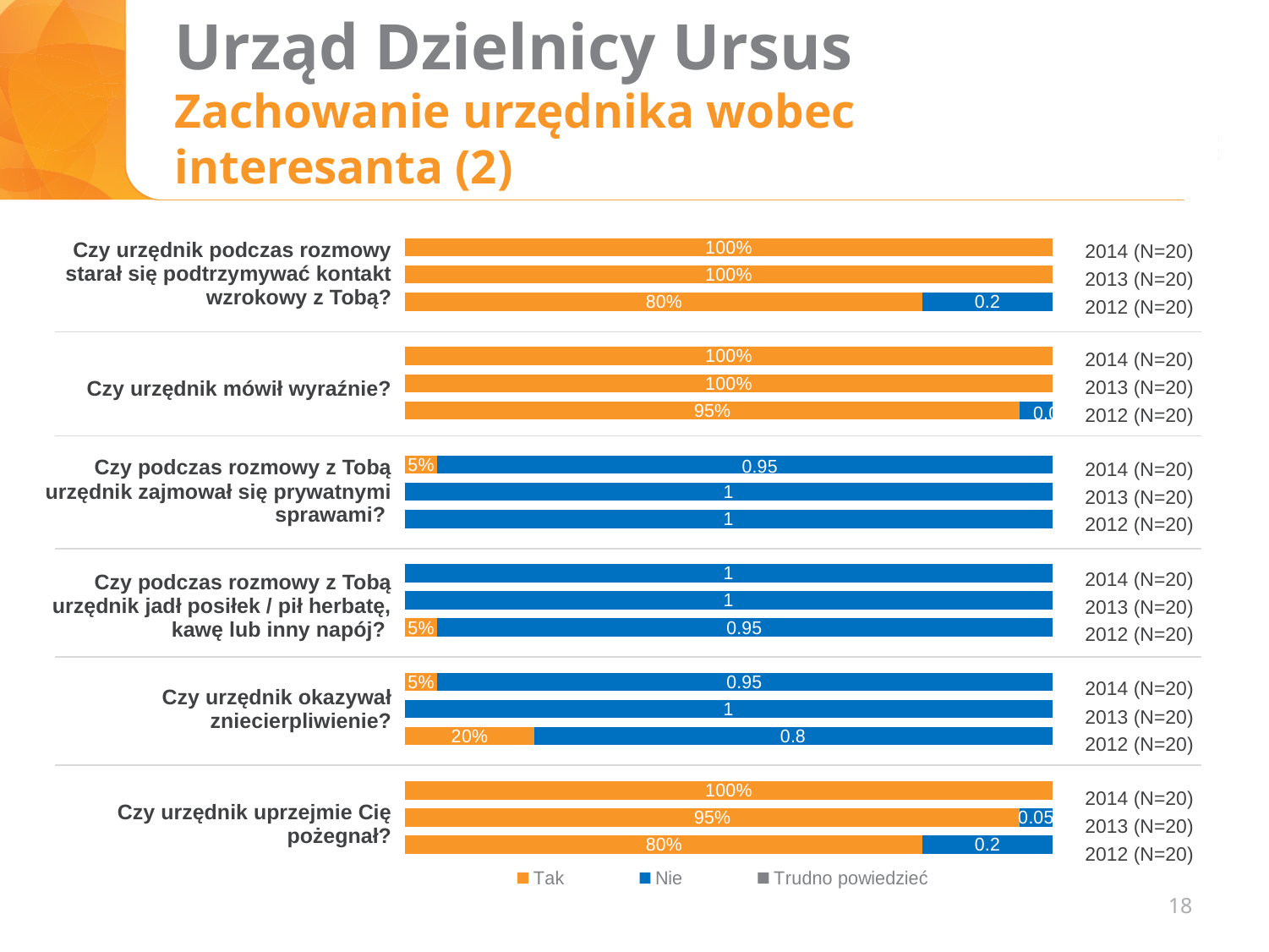
For the question "Czy urzędnik uprzejmie Cię pożegnał?", what is the "Tak" value for 2013 (N=20)? 95% For the question "Czy podczas rozmowy z Tobą urzędnik zajmował się prywatnymi sprawami?", what is the "Nie" value for 2014 (N=20)? 0.95 For the question "Czy urzędnik podczas rozmowy starał się podtrzymywać kontakt wzrokowy z Tobą?", what is the "Tak" value for 2012 (N=20)? 80% What kind of chart is shown on the slide? Stacked bar chart For the question "Czy urzędnik okazywał zniecierpliwienie?", what is the "Tak" value for 2012 (N=20)? 20% How many series does the chart legend list? 3 For the question "Czy urzędnik okazywał zniecierpliwienie?", what is the "Nie" value for 2012 (N=20)? 0.8 For the question "Czy urzędnik podczas rozmowy starał się podtrzymywać kontakt wzrokowy z Tobą?", what is the "Nie" value for 2012 (N=20)? 0.2 What are the entries in the chart legend? Tak, Nie, Trudno powiedzieć For the question "Czy urzędnik mówił wyraźnie?", what is the "Tak" value for 2012 (N=20)? 95% For the question "Czy urzędnik uprzejmie Cię pożegnał?", what is the "Nie" value for 2013 (N=20)? 0.05 For the question "Czy urzędnik okazywał zniecierpliwienie?", which year has the larger "Tak" share, 2012 or 2014? 2012